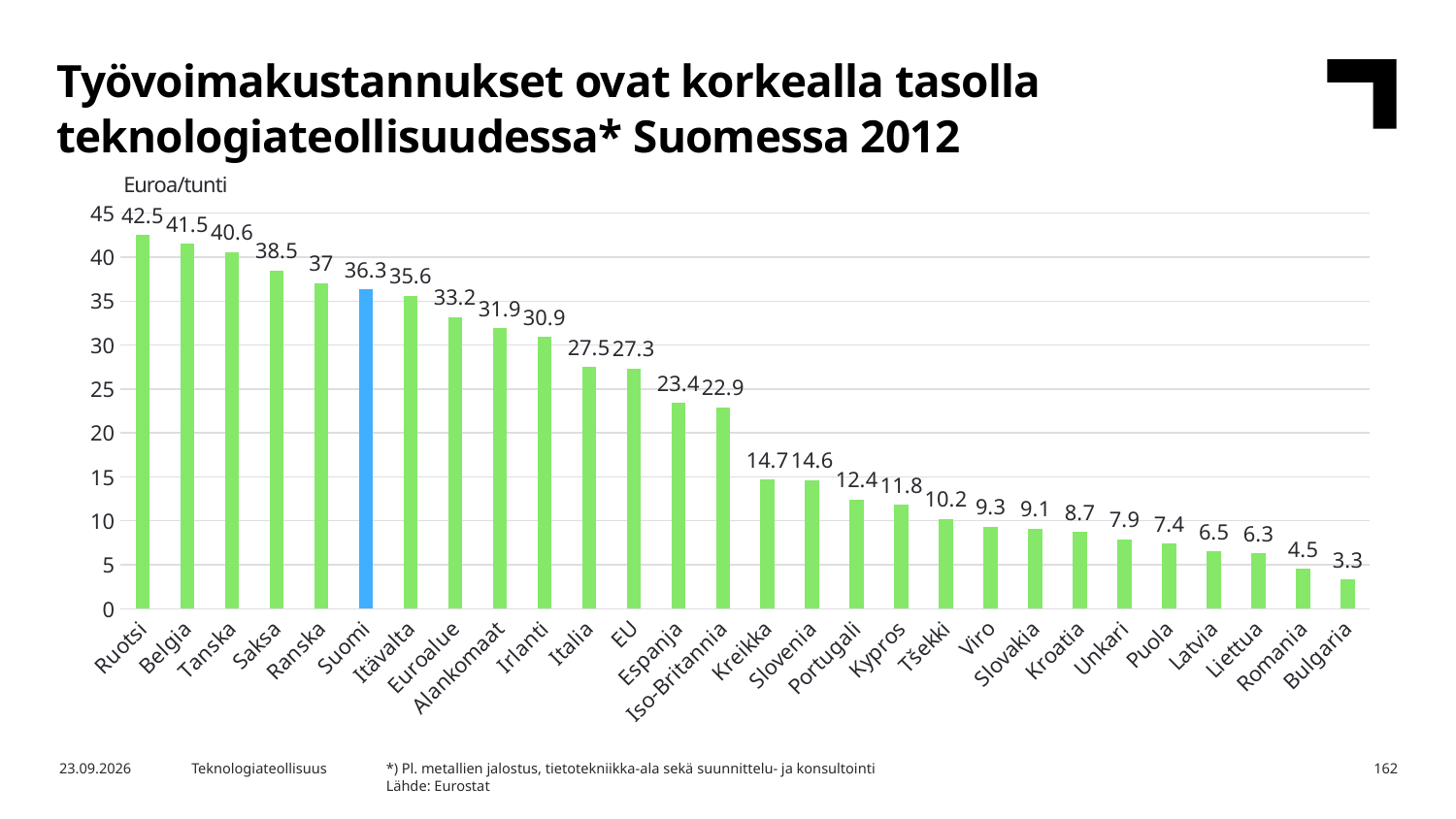
Which country has the highest value? Ruotsi Which is larger, the value for Italia or the value for EU? Italia How many countries or regions are shown on the x axis? 28 What is the difference between the values for Ruotsi and Suomi? 6.2 Do the values rise or fall from left to right along the x axis? fall What is the value for Alankomaat? 31.9 What is the value for Kreikka? 14.7 Which country has the lowest value? Bulgaria What is the value for Suomi? 36.3 Is the value for Espanja greater or less than 25? less What unit is shown above the y axis? Euroa/tunti What kind of chart is shown on the slide? bar chart